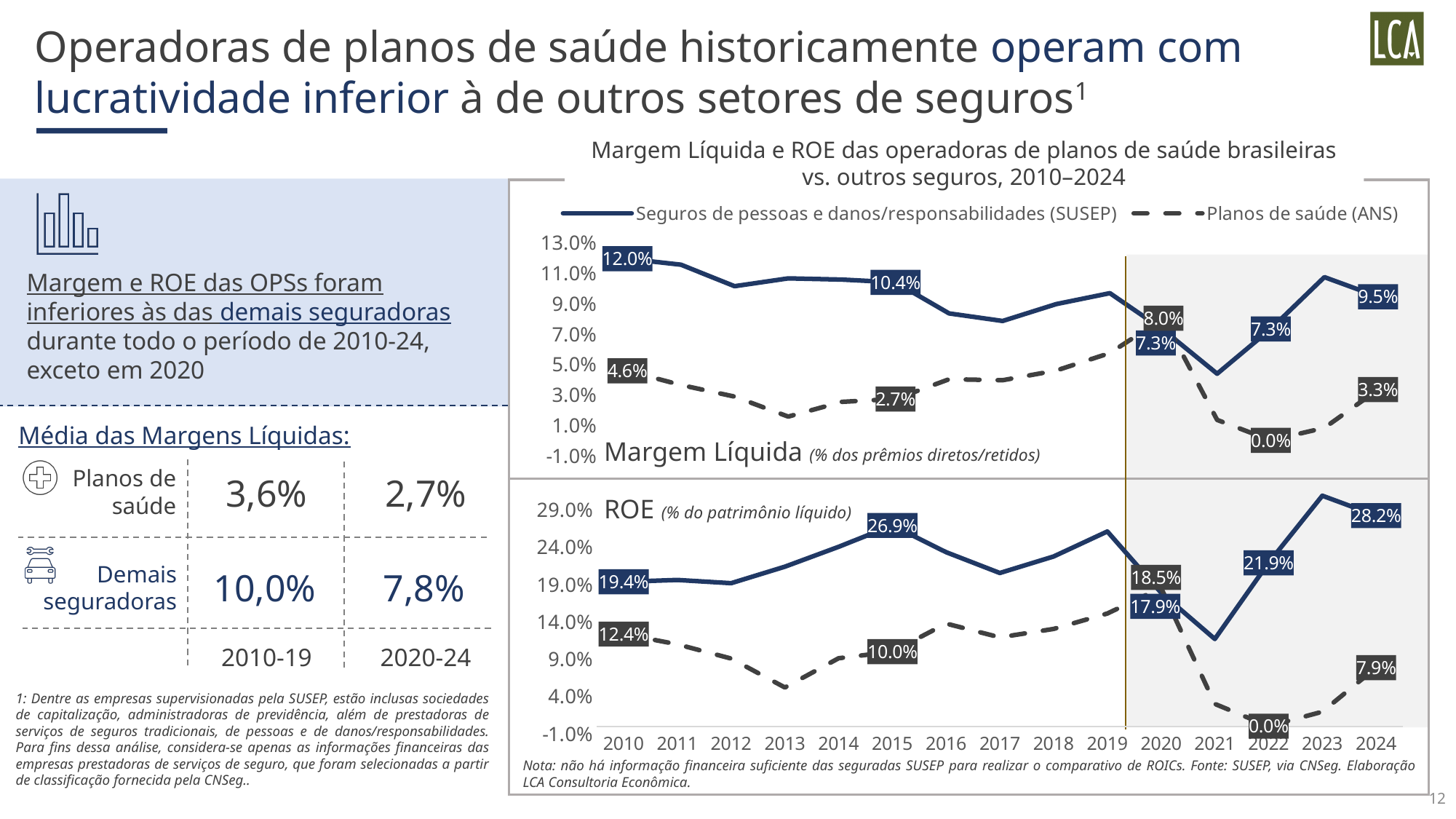
In the ROE chart, what is the value for Seguros de pessoas e danos/responsabilidades (SUSEP) in 2024? 28.2% In the Margem Líquida chart, what is the value for Planos de saúde (ANS) in 2024? 3.3% In the Margem Líquida chart, is the SUSEP value in 2021 greater or less than 5.0%? less In the Margem Líquida chart, what is the difference between the SUSEP and ANS values in 2015? 7.7 percentage points In the ROE chart, which series has the higher value in 2020, SUSEP or ANS? Planos de saúde (ANS) In the ROE chart, what is the value for Planos de saúde (ANS) in 2022? 0.0% How many years are shown on the x axis of the charts? 15 In the Margem Líquida chart, what is the value for Seguros de pessoas e danos/responsabilidades (SUSEP) in 2010? 12.0% In the ROE chart, is the ANS value in 2013 greater or less than 9.0%? less What type of chart is the ROE chart? Line chart How many series does the legend list? 2 In the ROE chart, does the ANS series rise or fall from 2020 to 2022? Fall